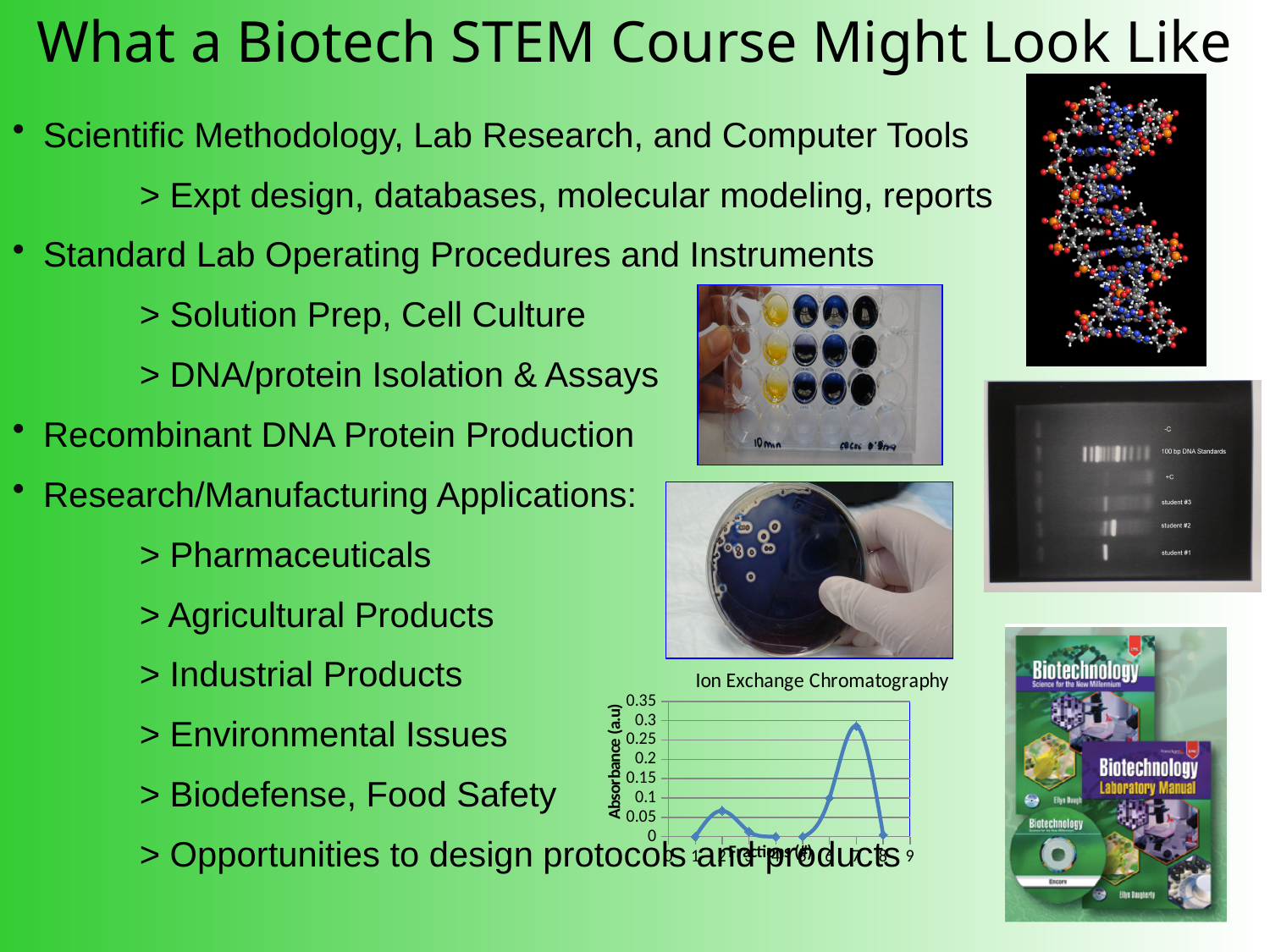
In the 'Ion Exchange Chromatography' chart, what is the highest value shown on the y axis? 0.35 In the 'Ion Exchange Chromatography' chart, which fraction has the highest absorbance? 7 What is the title of the chart on the slide? Ion Exchange Chromatography What is the y-axis label of the 'Ion Exchange Chromatography' chart? Absorbance (a.u) In the 'Ion Exchange Chromatography' chart, is the absorbance at fraction 2 greater or less than 0.15? less In the 'Ion Exchange Chromatography' chart, is the absorbance at fraction 6 greater or less than 0.25? less In the 'Ion Exchange Chromatography' chart, is the absorbance at fraction 7 greater or less than 0.35? less What kind of chart is the 'Ion Exchange Chromatography' chart? line chart In the 'Ion Exchange Chromatography' chart, which is larger, the absorbance at fraction 7 or at fraction 2? fraction 7